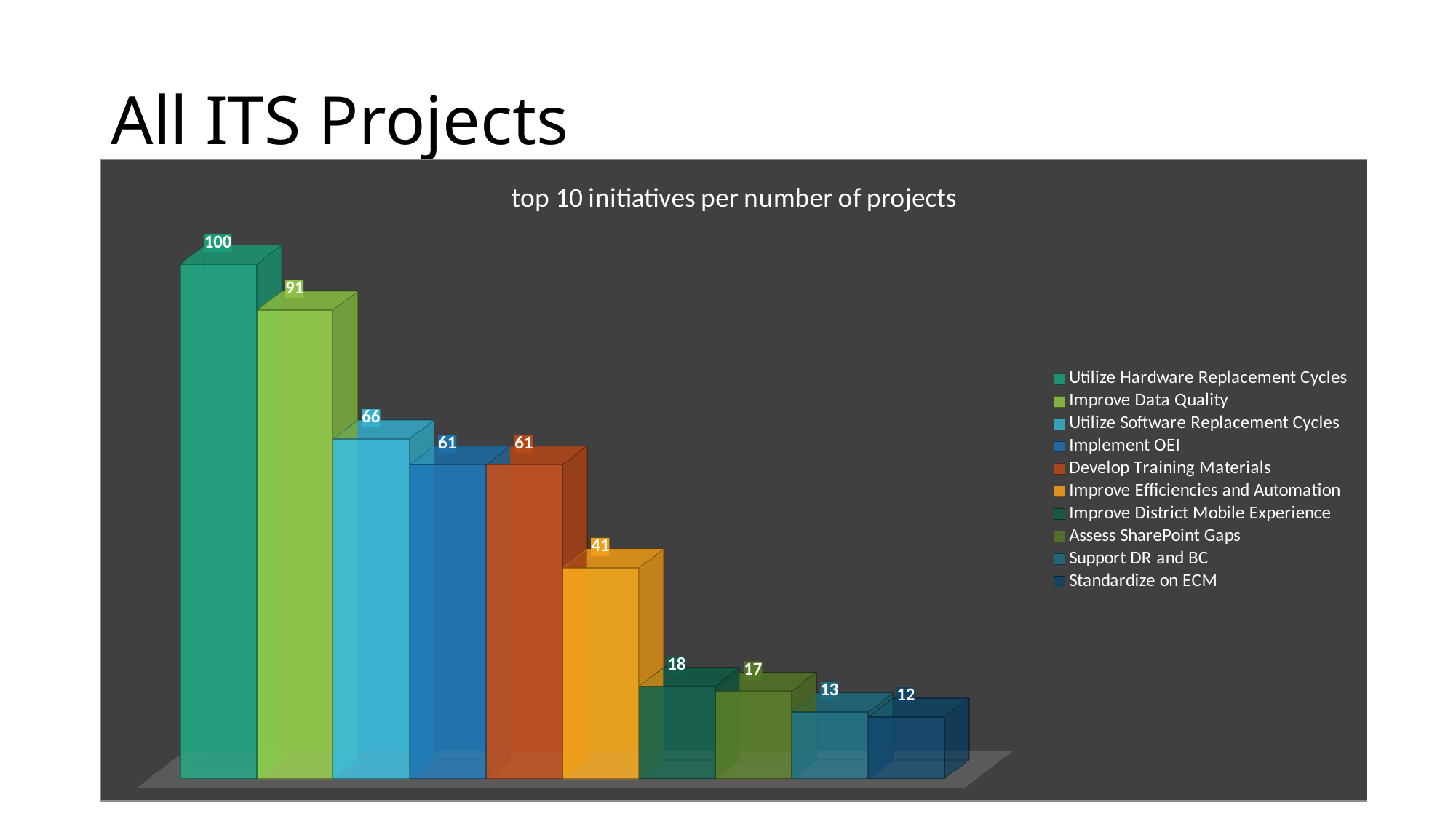
Which initiative has the highest number of projects? Utilize Hardware Replacement Cycles What is the value for Improve Efficiencies and Automation? 41 Which is larger, the value for Utilize Software Replacement Cycles or the value for Improve Efficiencies and Automation? Utilize Software Replacement Cycles What is the value for Utilize Hardware Replacement Cycles? 100 How many entries does the legend list? 10 What kind of chart is shown on the slide? Bar chart What is the title of the chart? top 10 initiatives per number of projects How many initiatives are plotted in the chart? 10 What is the value for Standardize on ECM? 12 Which initiative has the lowest number of projects? Standardize on ECM What is the value for Improve Data Quality? 91 What is the difference between the values for Utilize Hardware Replacement Cycles and Improve Data Quality? 9